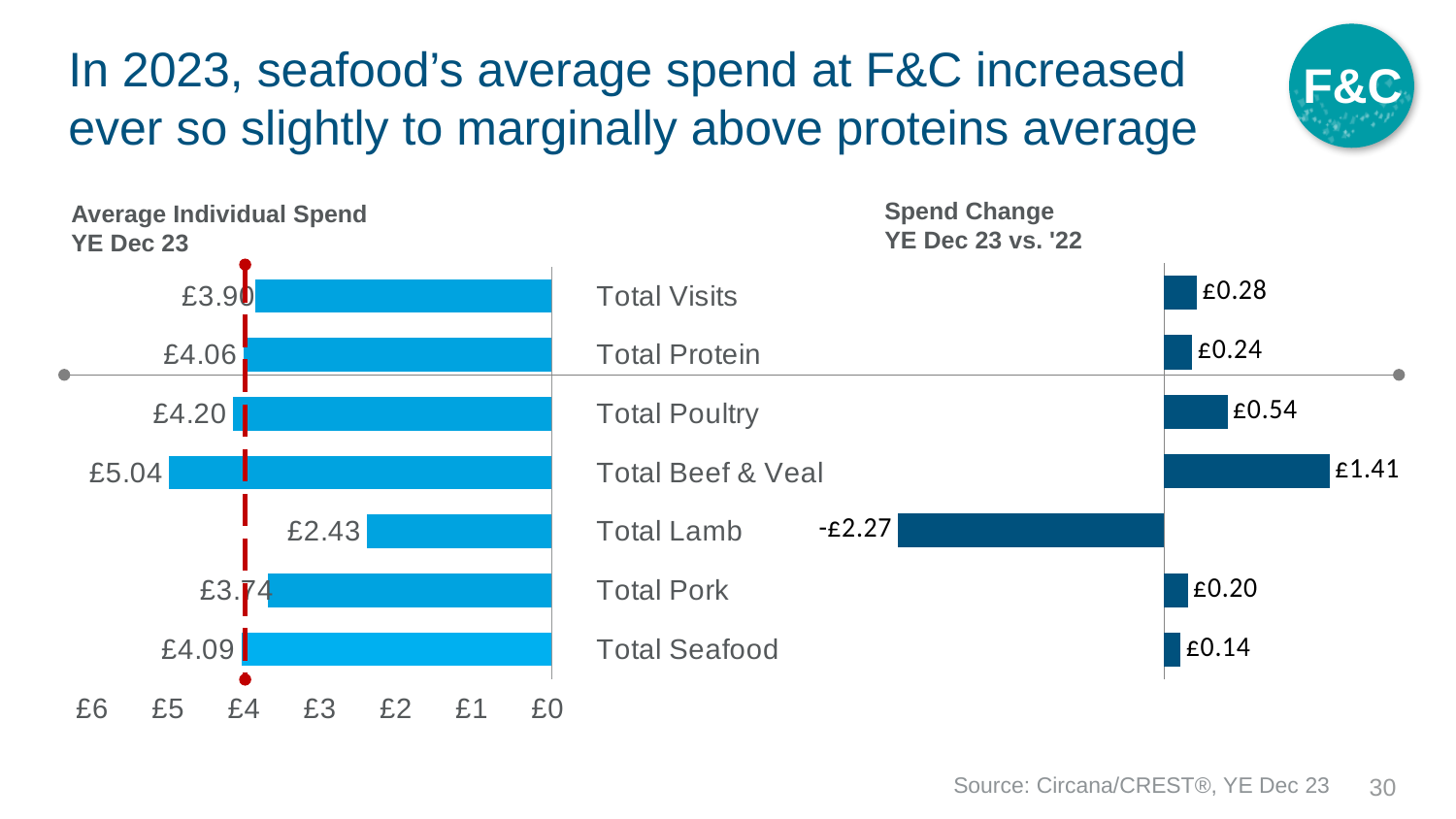
How many categories are shown in the Average Individual Spend YE Dec 23 chart? 7 What kind of chart is the Spend Change YE Dec 23 vs. '22 chart? bar chart In the Spend Change YE Dec 23 vs. '22 chart, which category has the highest value? Total Beef & Veal In the Average Individual Spend YE Dec 23 chart, what is the value for Total Beef & Veal? £5.04 In the Average Individual Spend YE Dec 23 chart, what is the value for Total Seafood? £4.09 In the Average Individual Spend YE Dec 23 chart, what is the difference between Total Seafood and Total Protein? £0.03 In the Spend Change YE Dec 23 vs. '22 chart, which is larger, Total Poultry or Total Pork? Total Poultry In the Spend Change YE Dec 23 vs. '22 chart, what is the value for Total Seafood? £0.14 In the Average Individual Spend YE Dec 23 chart, is the value for Total Poultry greater or less than £4? greater In the Average Individual Spend YE Dec 23 chart, which category has the lowest value? Total Lamb In the Average Individual Spend YE Dec 23 chart, which category has the highest value? Total Beef & Veal In the Spend Change YE Dec 23 vs. '22 chart, what is the value for Total Lamb? -£2.27